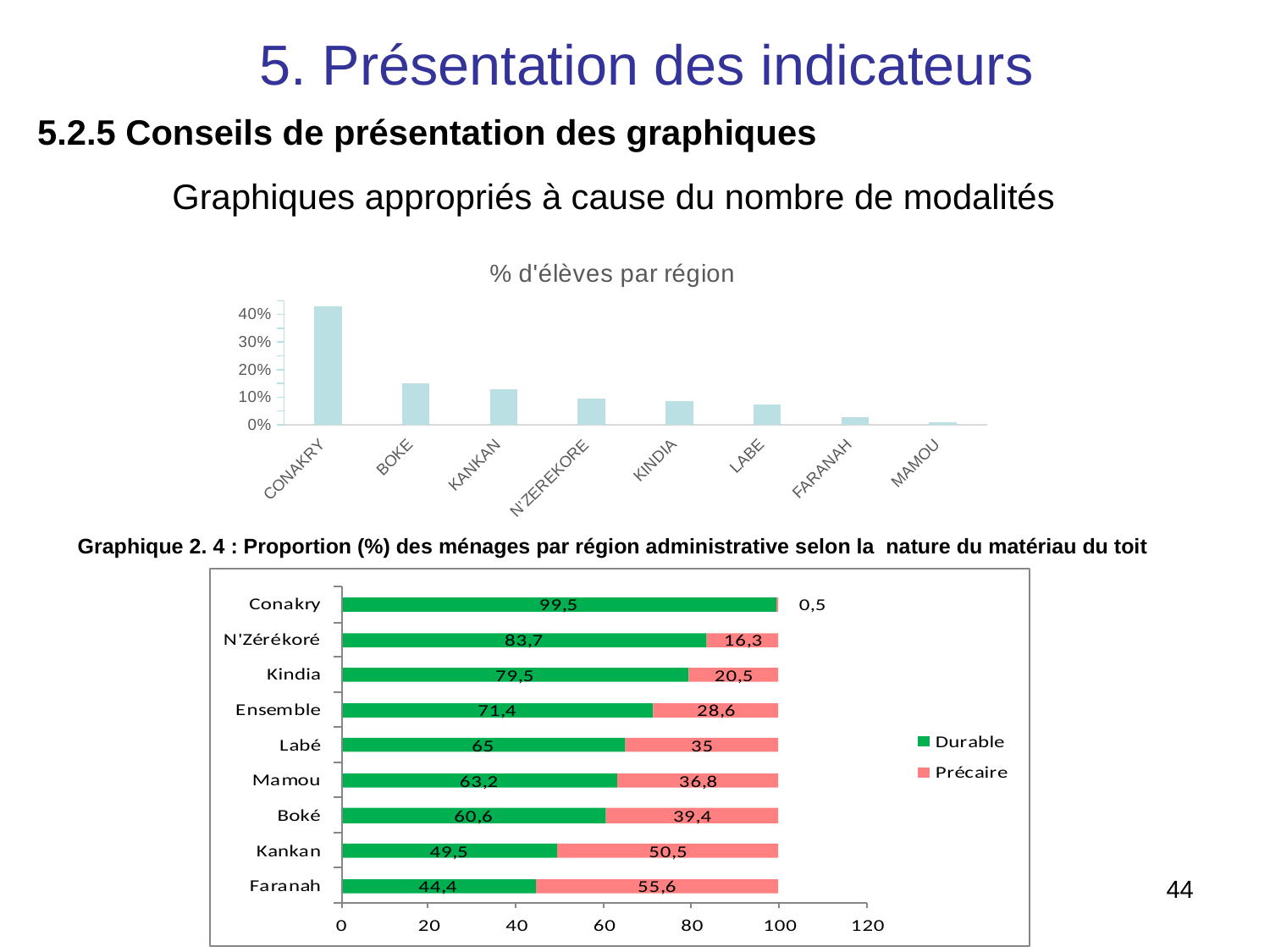
In the top chart '% d'élèves par région', which region has the highest value? CONAKRY In the bottom chart 'Graphique 2.4', what is the difference between the Durable values for Conakry and N'Zérékoré? 15,8 In the bottom chart 'Graphique 2.4', what is the Précaire value for Kankan? 50,5 In the top chart '% d'élèves par région', how many regions are shown on the x axis? 8 In the top chart '% d'élèves par région', is the value for FARANAH greater or less than 10%? less In the bottom chart 'Graphique 2.4', how many series does the legend list? 2 What kind of chart is the bottom chart 'Graphique 2.4'? Stacked bar chart In the bottom chart 'Graphique 2.4', which region has the lowest Durable value? Faranah In the bottom chart 'Graphique 2.4', what is the Durable value for Kindia? 79,5 In the top chart '% d'élèves par région', which region has the lowest value? MAMOU In the top chart '% d'élèves par région', is the value for BOKE greater or less than 10%? greater In the bottom chart 'Graphique 2.4', which is larger: the Précaire value for Labé or for Mamou? Mamou